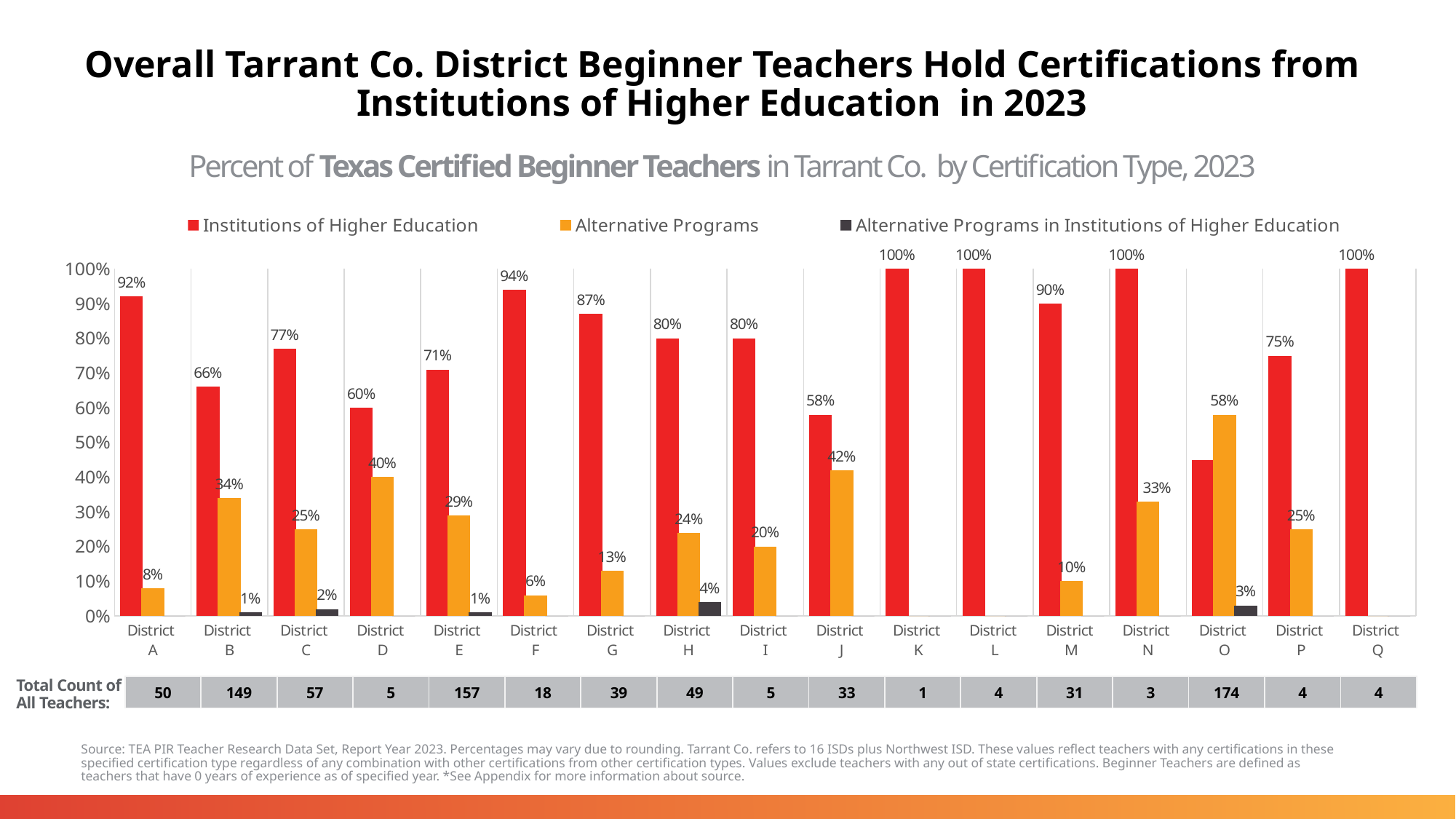
How many districts have an Institutions of Higher Education value of 100%? 4 How many series does the legend list? 3 What is the value for Alternative Programs in Institutions of Higher Education for District H? 4% How many districts are shown on the x axis? 17 What percentage of beginner teachers in District A hold certifications from Institutions of Higher Education? 92% What is the Alternative Programs value for District D? 40% Which district has the highest Alternative Programs percentage? District O What is the difference between the Institutions of Higher Education and Alternative Programs values for District B? 32 percentage points For District J, which is larger: Institutions of Higher Education or Alternative Programs? Institutions of Higher Education Is the Institutions of Higher Education value for District O greater or less than 50%? less What kind of chart is shown on the slide? Bar chart Which district has the lowest Institutions of Higher Education percentage? District O